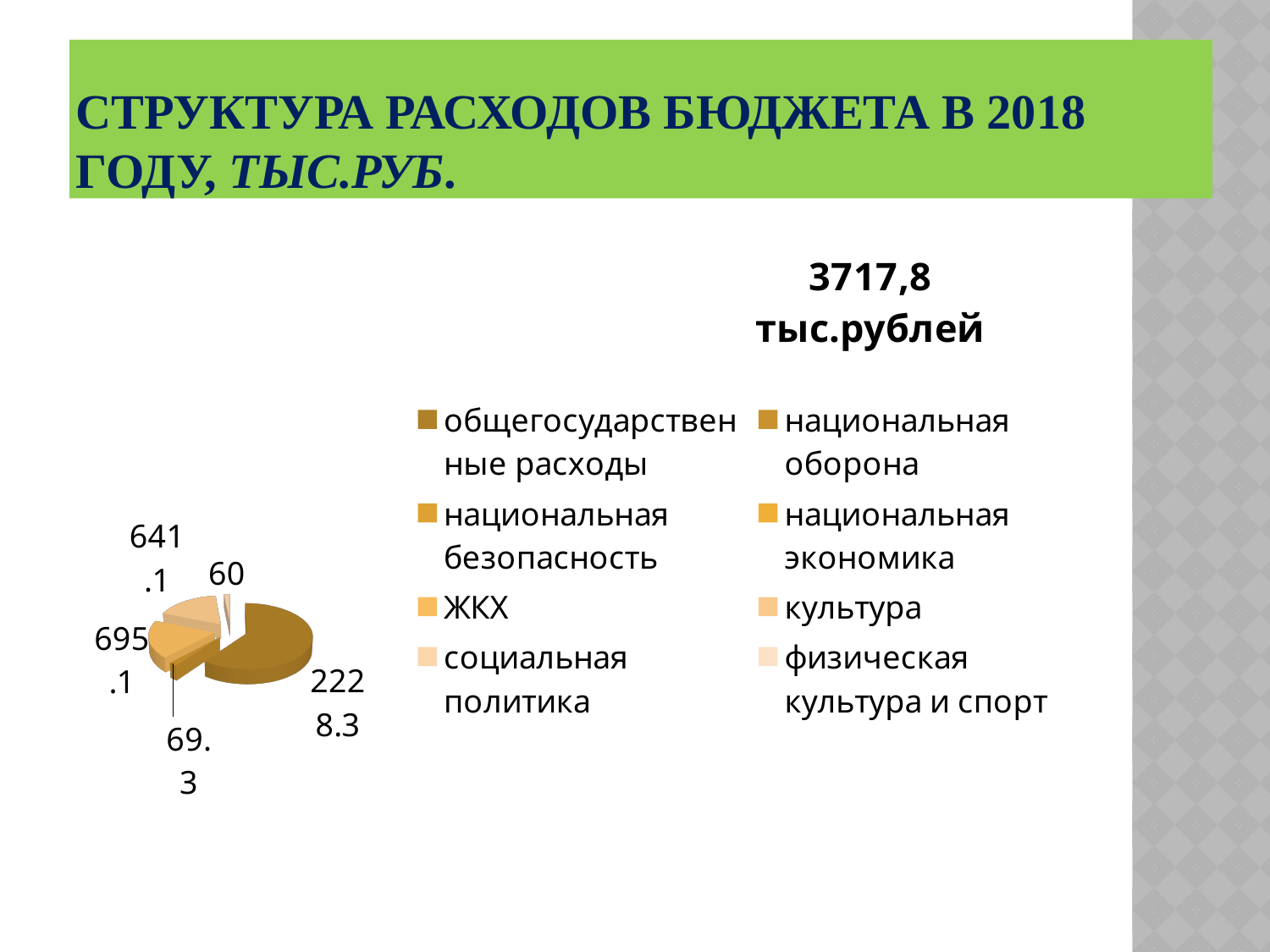
What is the difference between the slices labelled 695.1 and 641.1? 54.0 Which is larger, the slice labelled 695.1 or the slice labelled 641.1? 695.1 Which is larger, the slice labelled 69.3 or the slice labelled 60? 69.3 What is the title shown above the pie chart's legend? 3717,8 тыс.рублей What kind of chart is shown on the slide? pie chart How many data labels are printed on the pie chart? 5 What is the difference between the largest labelled slice (2228.3) and the smallest labelled slice (60)? 2168.3 How many entries does the legend of the pie chart list? 8 Which legend category corresponds to the largest slice of the pie chart? общегосударственные расходы What is the largest value labelled on the pie chart? 2228.3 What is the last entry listed in the pie chart's legend? физическая культура и спорт What is the smallest value labelled on the pie chart? 60